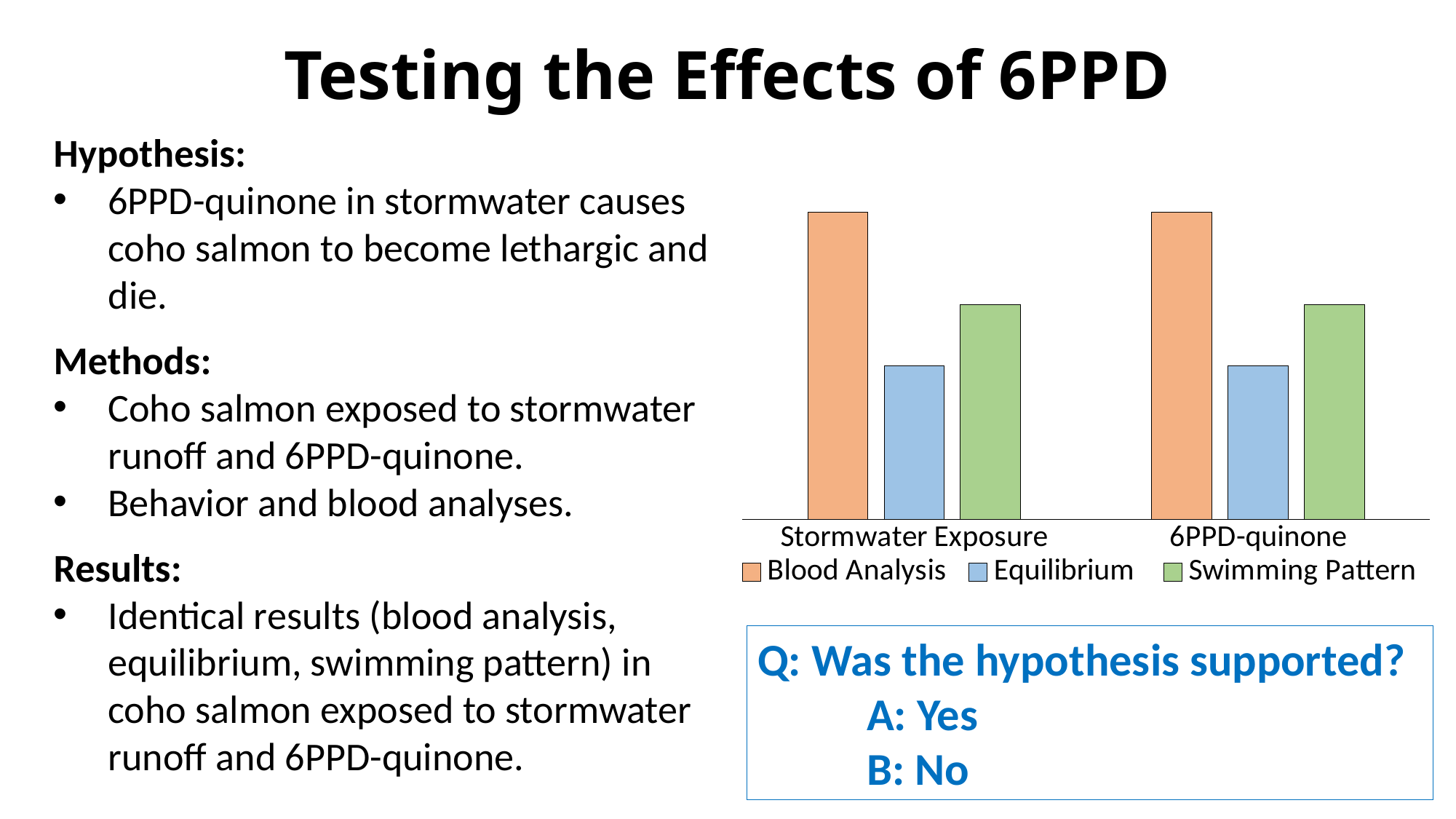
In the Stormwater Exposure category, which is larger: the Equilibrium bar or the Swimming Pattern bar? Swimming Pattern Does the Blood Analysis bar rise, fall, or stay the same from Stormwater Exposure to 6PPD-quinone? Stays the same What colour represents the Equilibrium series in the chart? Blue Which series has the highest bar in the 6PPD-quinone category? Blood Analysis What kind of chart is shown on the slide? Bar chart What are the two categories labelled on the x axis of the chart? Stormwater Exposure and 6PPD-quinone How many series does the chart's legend list? 3 Which series has the lowest bar in the Stormwater Exposure category? Equilibrium In the 6PPD-quinone category, which is larger: the Blood Analysis bar or the Swimming Pattern bar? Blood Analysis Which series has the highest bar in the Stormwater Exposure category? Blood Analysis Which series has the lowest bar in the 6PPD-quinone category? Equilibrium How many categories are shown on the x axis of the chart? 2